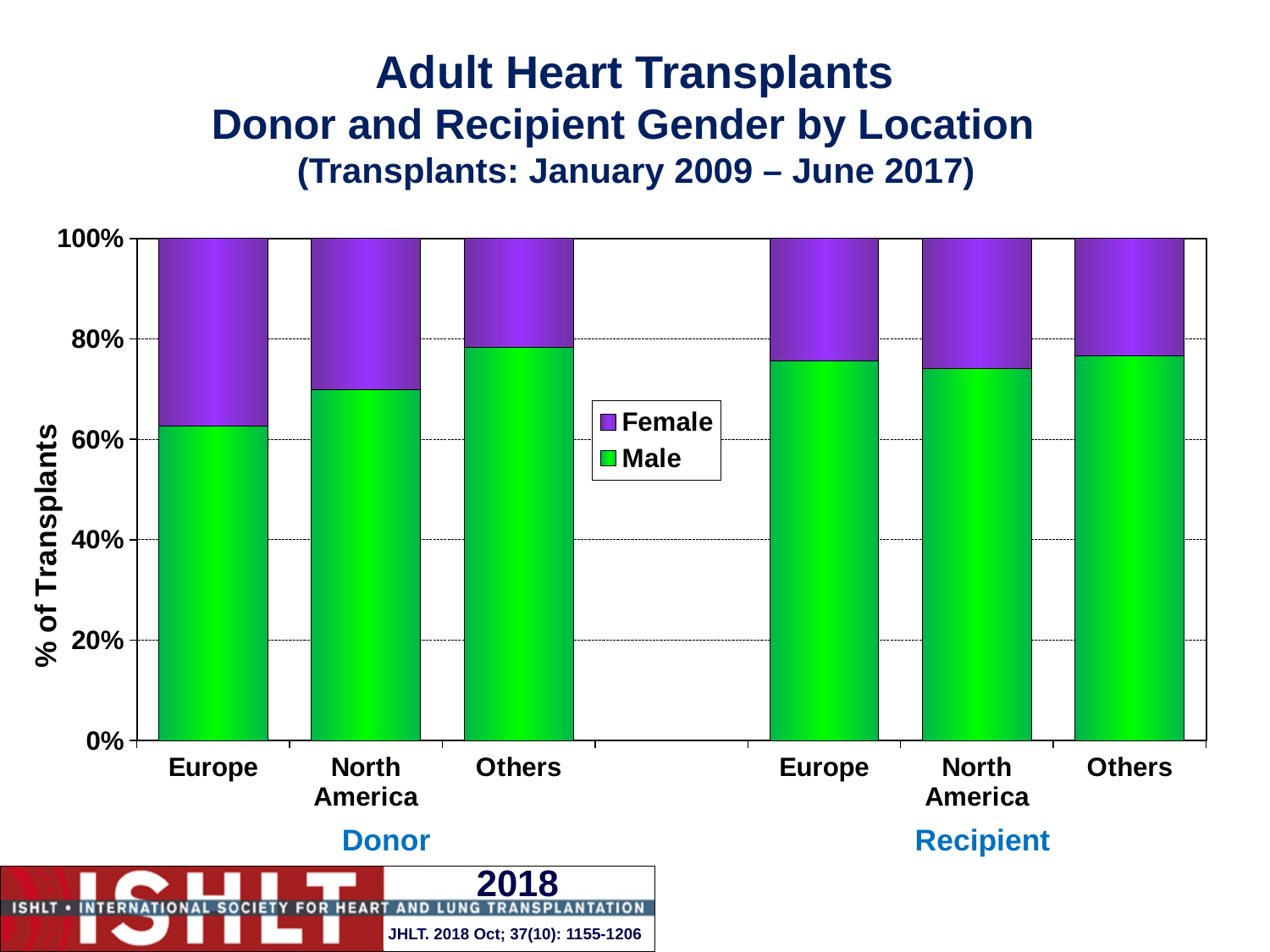
Among the Donor bars, does the Male share rise or fall from Europe to Others? Rise What kind of chart is shown on the slide? Stacked bar chart Which bar has the highest Female share? Donor Europe Is the Male share for Donor Others greater or less than 80%? less Is the Male share for Recipient Europe greater or less than 80%? less How many series does the legend list? 2 Which bar has the lowest Male share? Donor Europe How many bars are plotted in the chart? 6 Is the Male share for Donor North America greater or less than 60%? greater Which has the larger Male share, Donor Europe or Donor North America? Donor North America Which colour represents Female in the legend? Purple